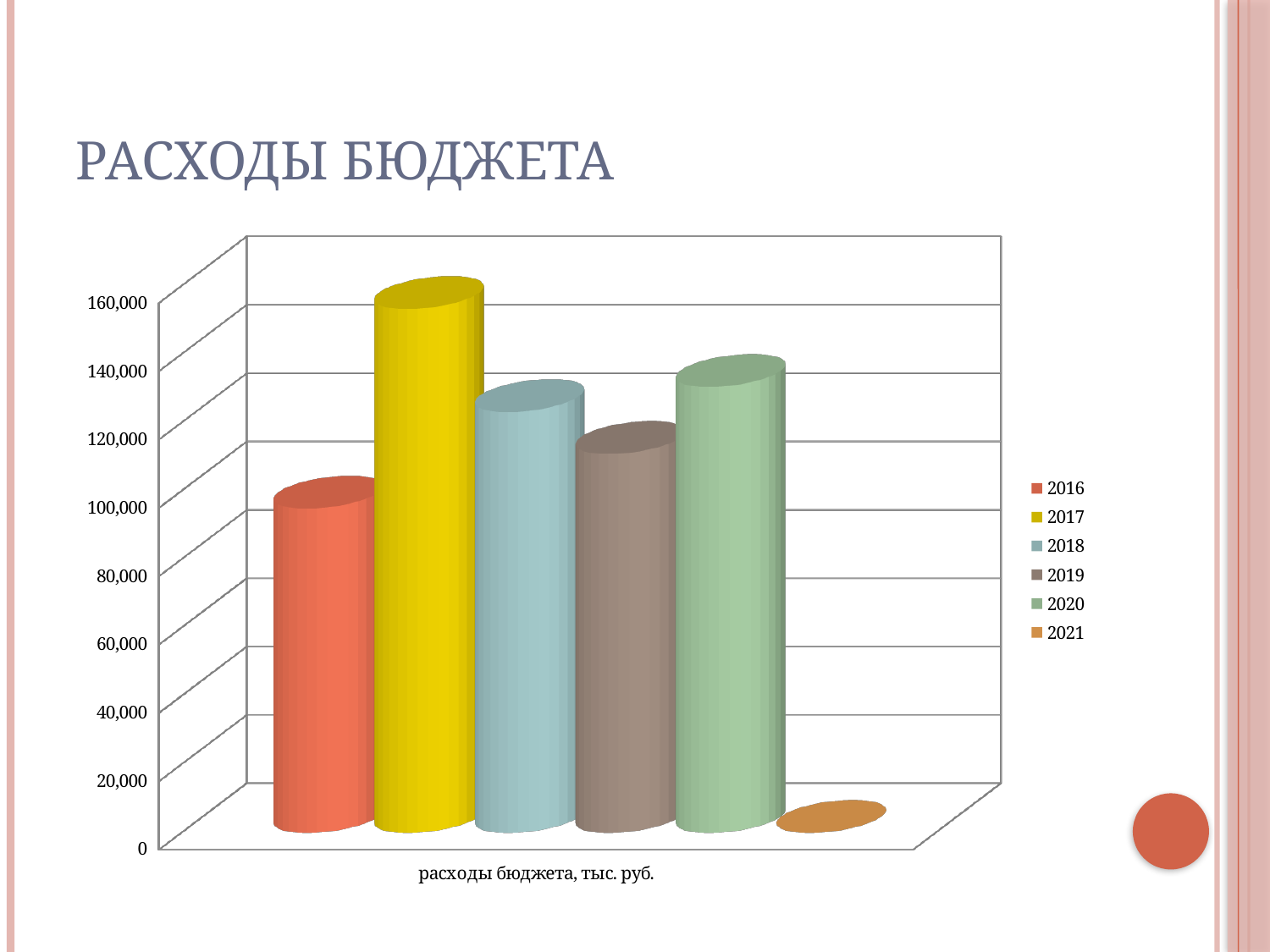
Is the value for 2016 greater or less than 120,000? less Which is larger, the value for 2017 or the value for 2016? 2017 Which year has the highest budget expenditure? 2017 What kind of chart is shown on the slide? bar chart Is the value for 2020 greater or less than 120,000? greater What is the title of the slide containing the chart? РАСХОДЫ БЮДЖЕТА Which is larger, the value for 2020 or the value for 2019? 2020 How many series does the legend list? 6 Is the value for 2019 greater or less than 100,000? greater